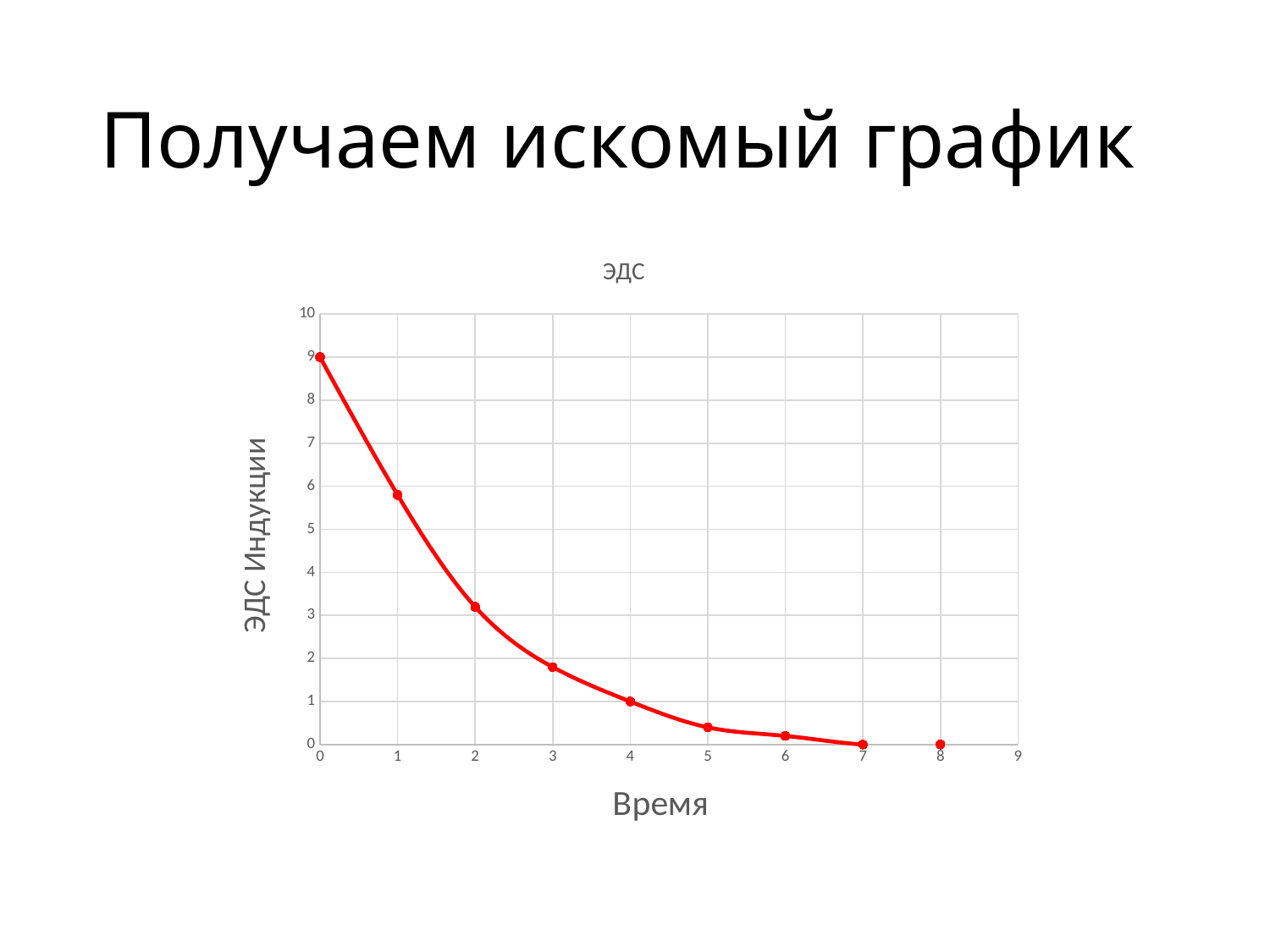
What is the label of the x axis? Время Which is larger, the value at Время = 3 or the value at Время = 5? Время = 3 What kind of chart is shown on the slide? line chart What is the value of ЭДС Индукции at Время = 4? 1 How many data points are plotted on the chart? 9 What is the title of the chart? ЭДС Is the value at Время = 2 greater or less than 4? less Do the values rise or fall as Время increases? fall What is the value of ЭДС Индукции at Время = 0? 9 What is the value of ЭДС Индукции at Время = 7? 0 Is the value at Время = 1 greater or less than 5? greater At which value of Время is ЭДС Индукции highest? 0